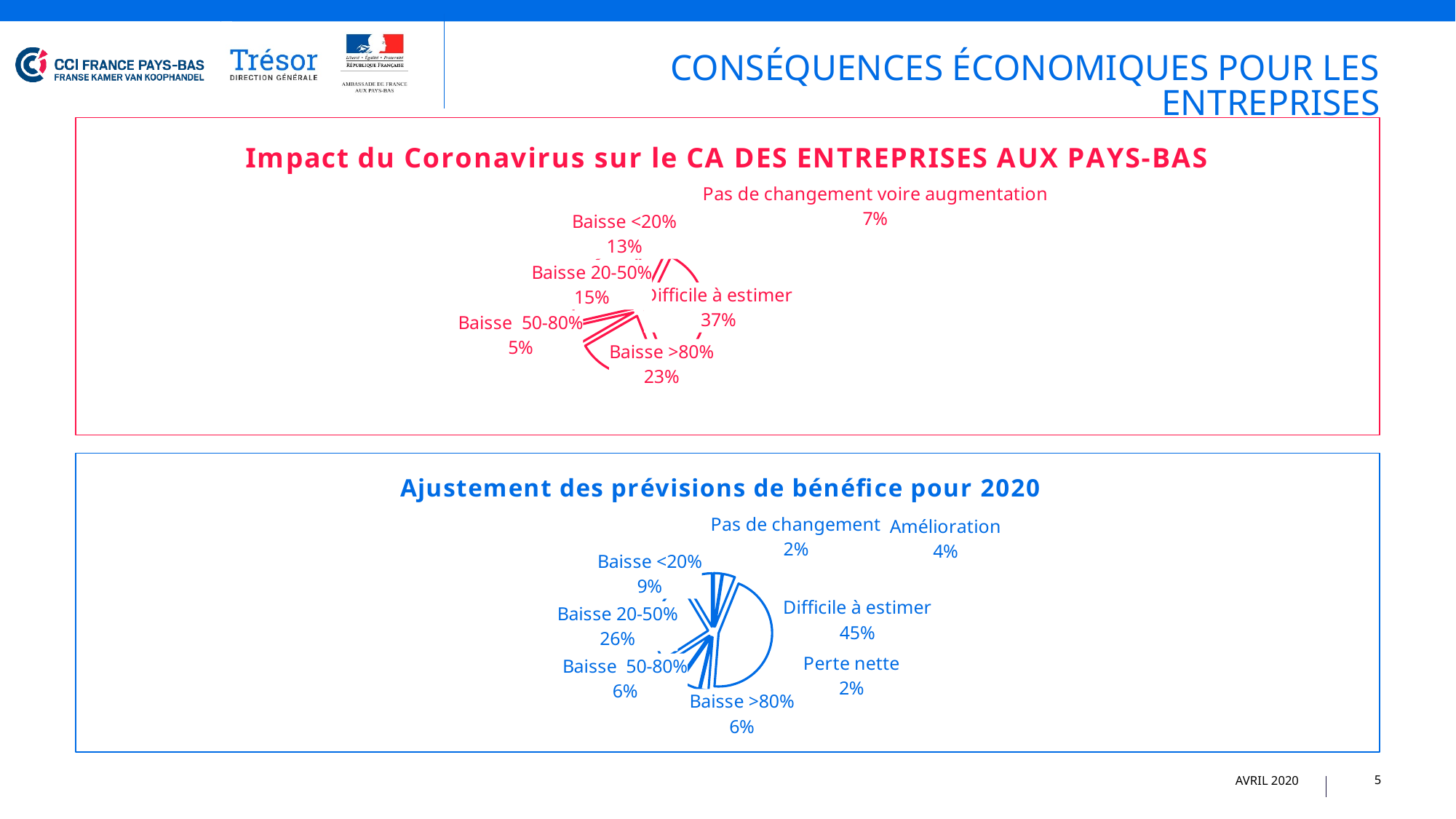
In the chart 'Ajustement des prévisions de bénéfice pour 2020', which category has the largest share? Difficile à estimer In the chart 'Ajustement des prévisions de bénéfice pour 2020', what share is labelled for 'Baisse 20-50%'? 26% In the chart 'Impact du Coronavirus sur le CA DES ENTREPRISES AUX PAYS-BAS', which category has the smallest share? Baisse 50-80% How many categories are shown in the chart 'Impact du Coronavirus sur le CA DES ENTREPRISES AUX PAYS-BAS'? 6 In the chart 'Impact du Coronavirus sur le CA DES ENTREPRISES AUX PAYS-BAS', what share is labelled for 'Baisse >80%'? 23% How many categories are shown in the chart 'Ajustement des prévisions de bénéfice pour 2020'? 8 What type of chart is 'Ajustement des prévisions de bénéfice pour 2020'? Pie chart In the chart 'Impact du Coronavirus sur le CA DES ENTREPRISES AUX PAYS-BAS', what is the difference in percentage points between 'Baisse 20-50%' and 'Baisse <20%'? 2 percentage points In the chart 'Ajustement des prévisions de bénéfice pour 2020', which is larger: 'Baisse <20%' or 'Baisse 50-80%'? Baisse <20% In the chart 'Ajustement des prévisions de bénéfice pour 2020', what share is labelled for 'Amélioration'? 4% In the chart 'Impact du Coronavirus sur le CA DES ENTREPRISES AUX PAYS-BAS', which category has the largest share? Difficile à estimer In the chart 'Impact du Coronavirus sur le CA DES ENTREPRISES AUX PAYS-BAS', what share is labelled for 'Difficile à estimer'? 37%